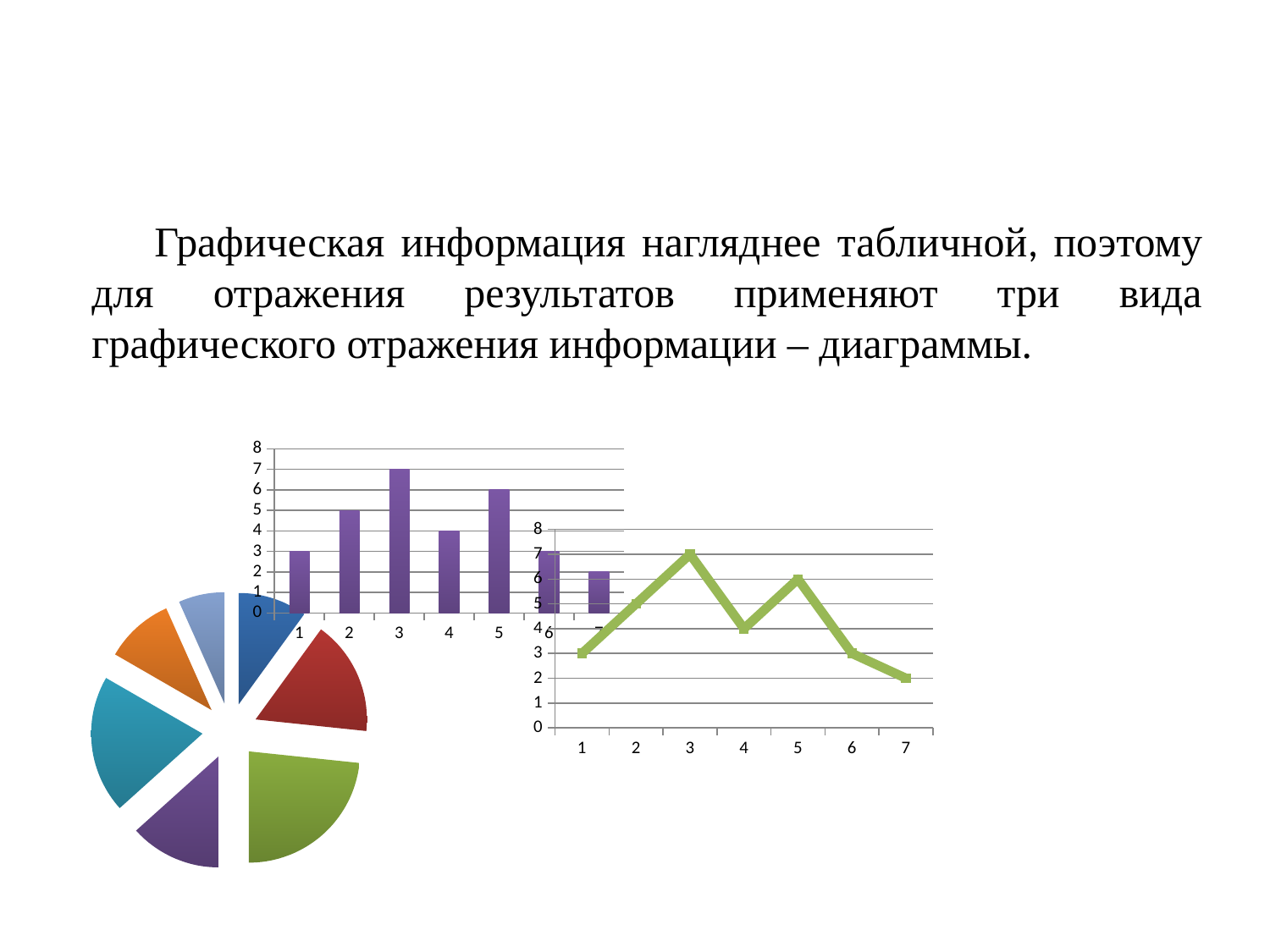
In the green line chart, what is the value at category 5? 6 What kind of chart is the chart in the lower left of the slide? pie chart In the green line chart, which category has the lowest point? 7 In the green line chart, how many points are plotted along the x axis? 7 In the purple bar chart, what is the value for category 1? 3 What kind of chart is the chart with purple bars in the upper middle of the slide? bar chart In the purple bar chart, what is the difference between the values for category 3 and category 1? 4 In the pie chart, how many slices are there? 7 What kind of chart is the chart with the green line on the right of the slide? line chart In the green line chart, which category has the highest point? 3 In the purple bar chart, what is the value for category 3? 7 In the purple bar chart, which category has the highest bar? 3